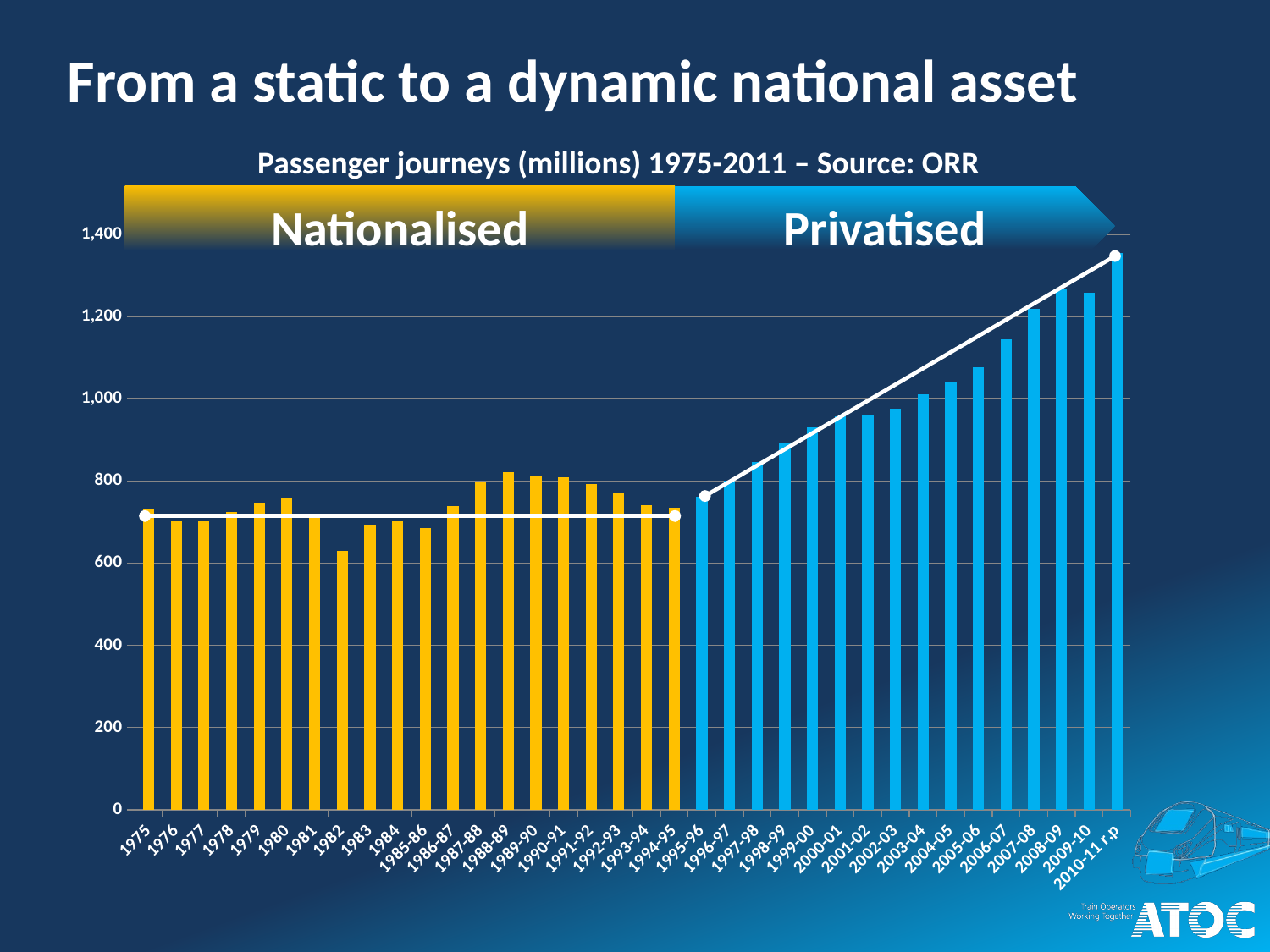
What kind of chart is shown on the slide? bar chart Which is larger, the value for 1988-89 or the value for 1982? 1988-89 Do the values generally rise or fall from 1995-96 to 2010-11 r.p? rise What is the title of the chart? Passenger journeys (millions) 1975-2011 – Source: ORR How many years (categories) are plotted along the x axis? 36 Is the value for 2010-11 r.p greater or less than 1,200? greater What colour are the bars in the Privatised period? blue Which year has the lowest number of passenger journeys? 1982 Which year has the highest number of passenger journeys? 2010-11 r,p Is the value for 1995-96 greater or less than 800? less Is the value for 1982 greater or less than 800? less